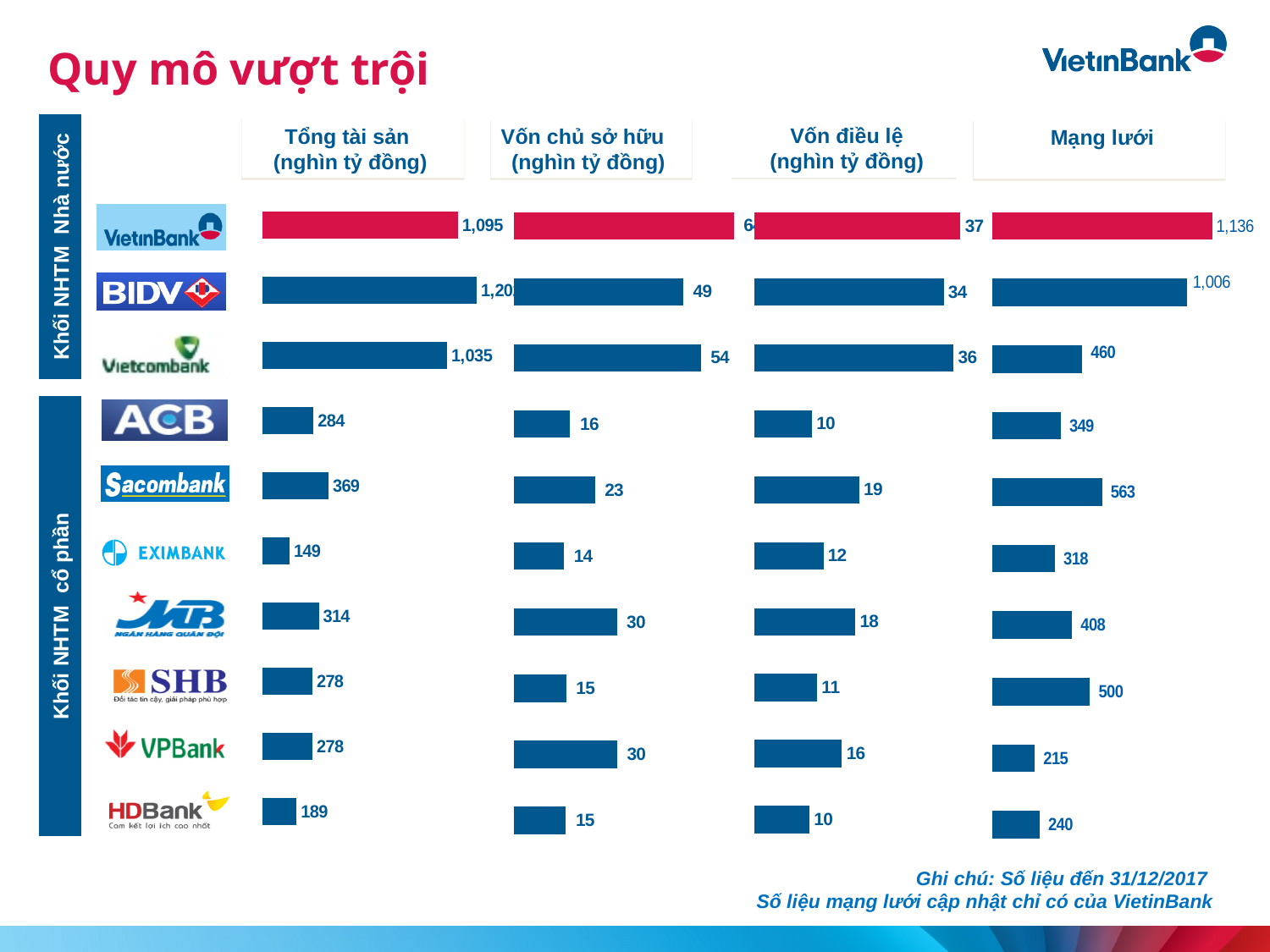
In the Mạng lưới chart, which bank has the lowest value? VPBank In the Mạng lưới chart, what is the difference between the values for VietinBank and BIDV? 130 How many banks are shown in the Tổng tài sản (nghìn tỷ đồng) chart? 10 What kind of chart is the Mạng lưới chart? Bar chart In the Tổng tài sản (nghìn tỷ đồng) chart, what is the value for Vietcombank? 1,035 In the Vốn điều lệ (nghìn tỷ đồng) chart, which bank has the highest value? VietinBank In the Vốn điều lệ (nghìn tỷ đồng) chart, what is the value for Sacombank? 19 In the Vốn chủ sở hữu (nghìn tỷ đồng) chart, what is the value for MB? 30 In the Mạng lưới chart, what is the value for Sacombank? 563 In the Tổng tài sản (nghìn tỷ đồng) chart, which bank has the lowest value? Eximbank In the Mạng lưới chart, which bank has the highest value? VietinBank In the Vốn chủ sở hữu (nghìn tỷ đồng) chart, which is larger, the value for Vietcombank or the value for BIDV? Vietcombank